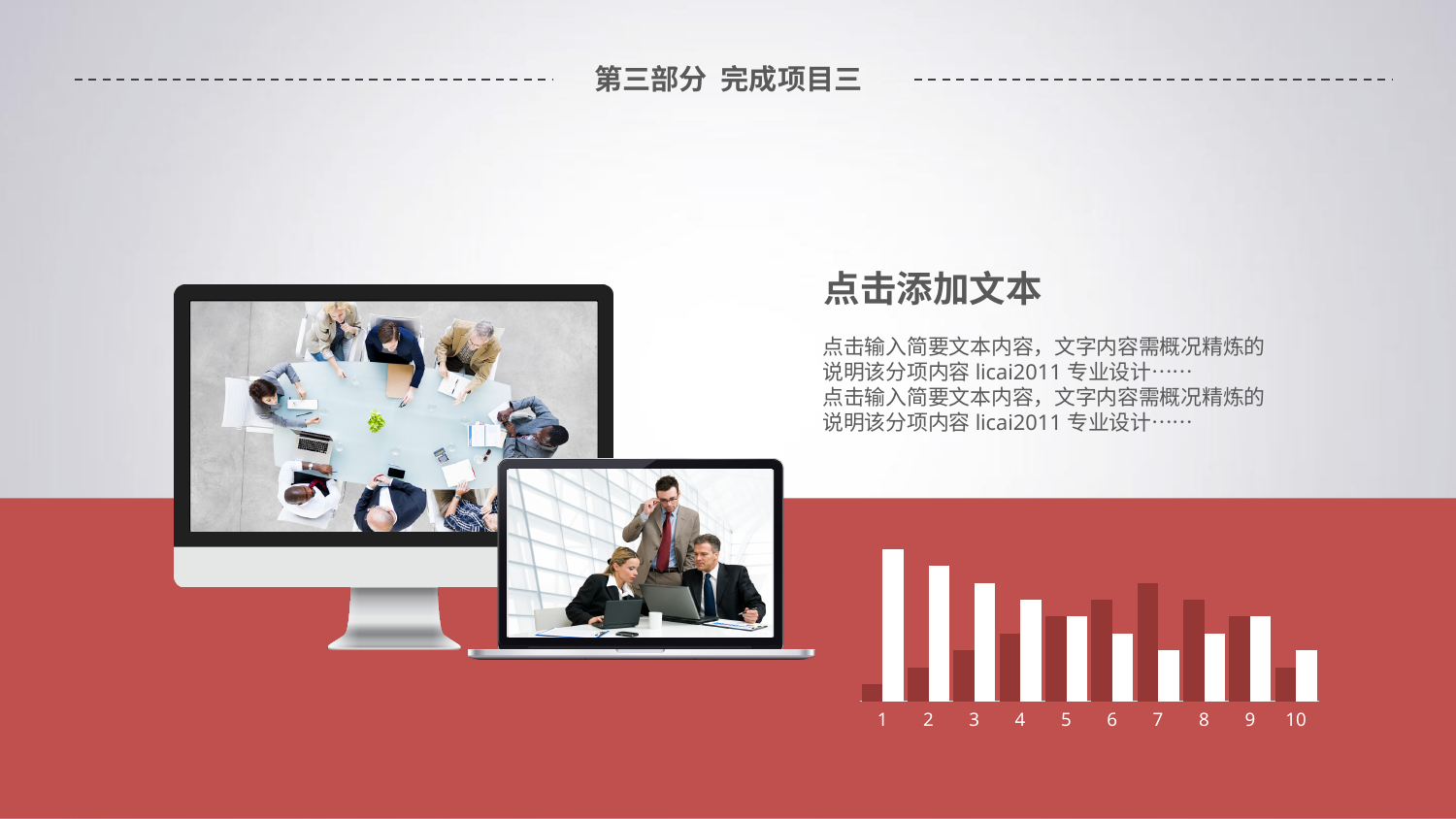
How many categories are shown on the x axis of the bar chart? 10 At category 1, which bar is taller, the white bar or the dark red bar? white bar Which category has the tallest white bar? 1 How many bars are plotted for each category in the bar chart? 2 What two colours are used for the bars in the chart? white and dark red Which category has the tallest dark red bar? 7 Do the dark red bars rise or fall from category 1 to category 7? rise What kind of chart is shown on the slide? bar chart Which category has the shortest dark red bar? 1 At category 7, which bar is taller, the white bar or the dark red bar? dark red bar Do the white bars rise or fall from category 1 to category 10? fall